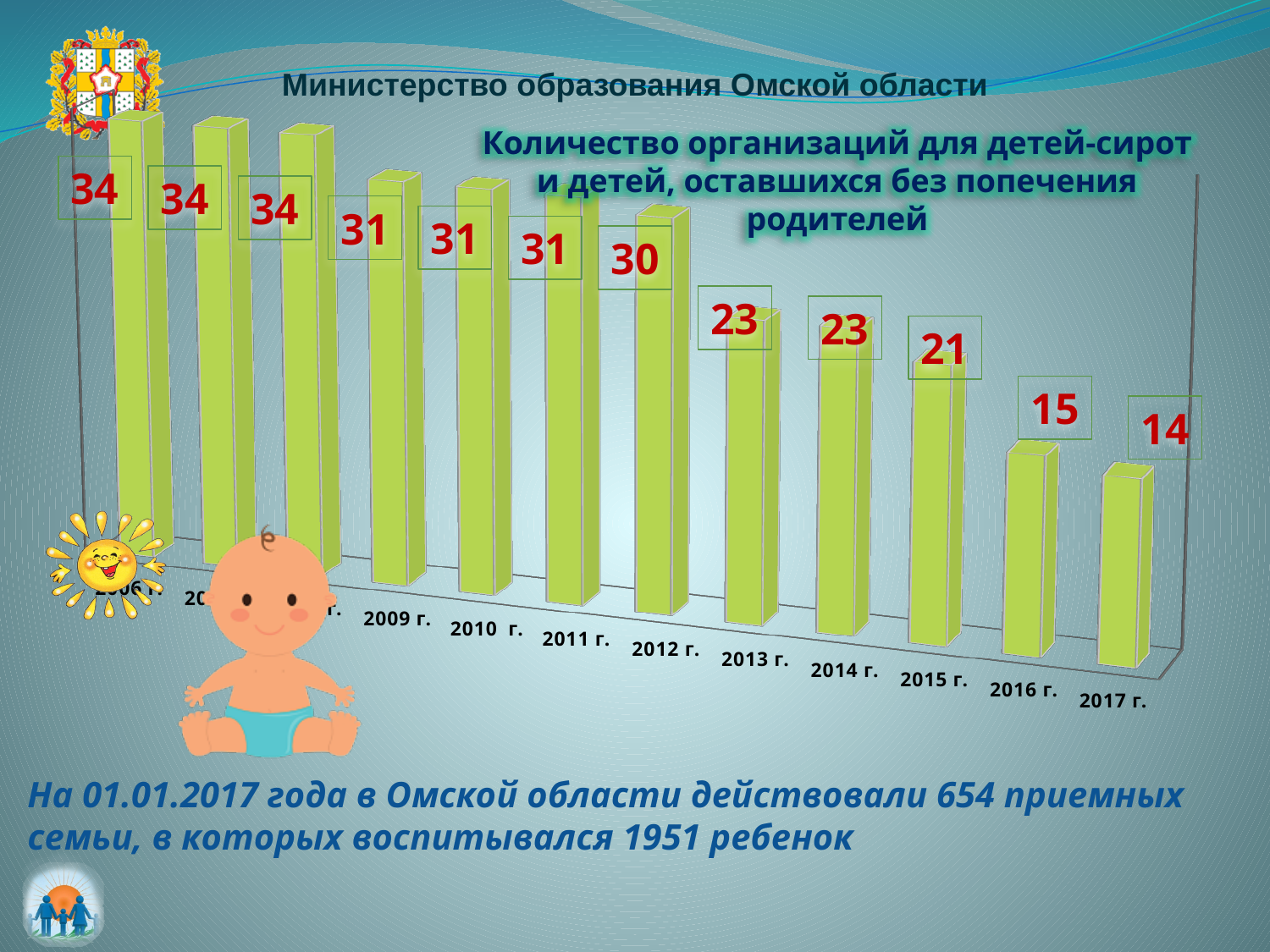
Which year has the lowest value? 2017 г. What is the value for 2015 г.? 21 Which is larger, the value for 2012 г. or the value for 2014 г.? 2012 г. What is the value for 2017 г.? 14 What is the difference between the values for 2013 г. and 2016 г.? 8 What kind of chart is shown on the slide? bar chart How many bars are shown on the chart? 12 Do the values rise or fall from left to right along the x axis? fall What is the difference between the values for 2009 г. and 2017 г.? 17 What is the highest value shown on the chart? 34 What is the value for 2012 г.? 30 What is the value for 2013 г.? 23